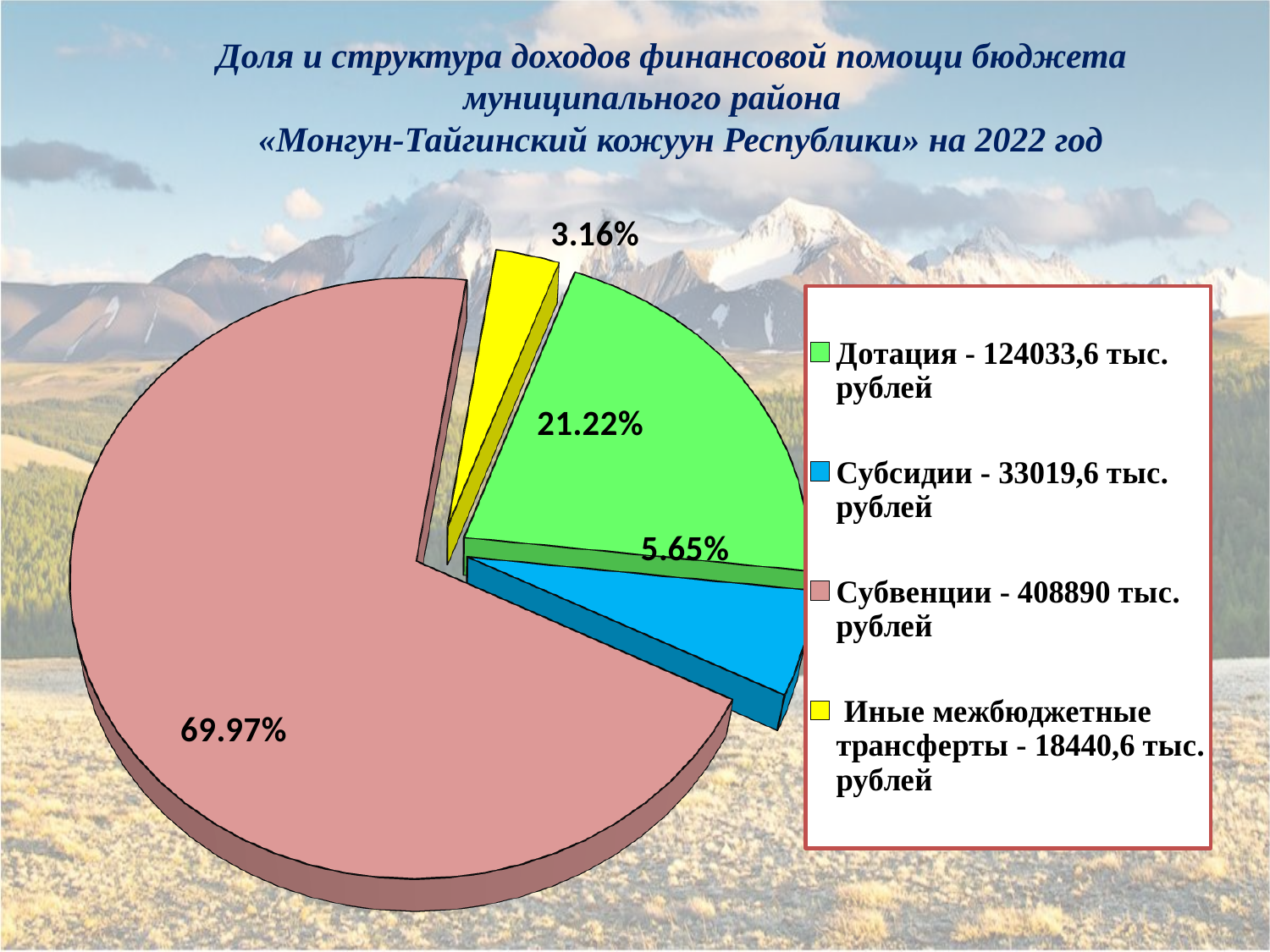
What kind of chart is shown on the slide? Pie chart What share of the pie does Субсидии represent? 5.65% Which has a larger share, Субсидии or Дотация? Дотация Which category has the smallest share of the pie? Иные межбюджетные трансферты How many categories does the pie chart have? 4 What share of the pie does Иные межбюджетные трансферты represent? 3.16% What is the difference in percentage points between the shares of Субвенции and Дотация? 48.75% What share of the pie does Дотация represent? 21.22% Which category has the largest share of the pie? Субвенции Which colour represents Субвенции in the pie chart? Pink According to the legend, what is the amount for Субсидии? 33019,6 тыс. рублей